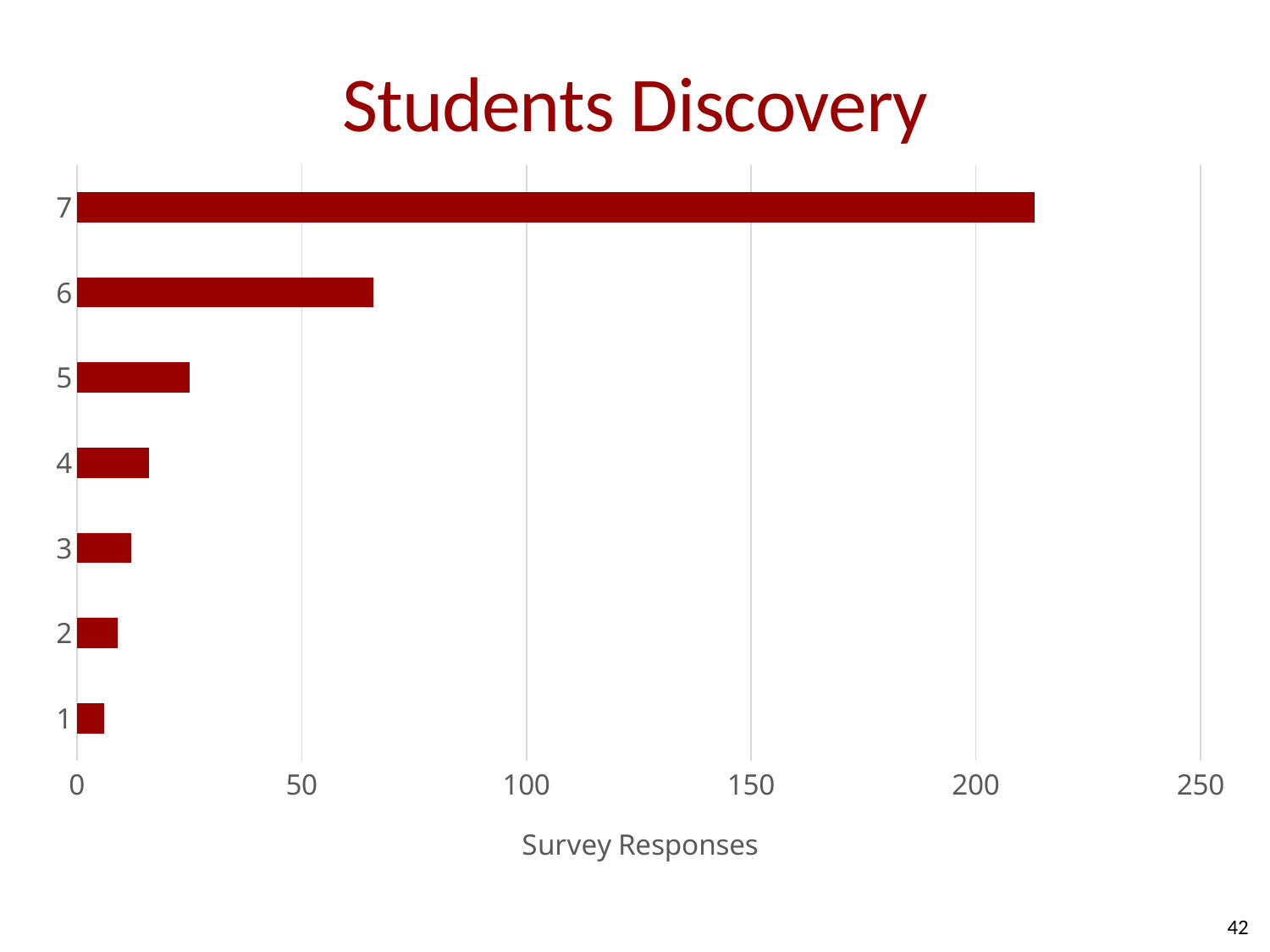
Is the value for category 6 greater or less than 50? greater What is the title of the chart? Students Discovery What is the label on the horizontal axis? Survey Responses Which category has the lowest number of survey responses? 1 Is the value for category 6 greater or less than 100? less Is the value for category 5 greater or less than 50? less What kind of chart is shown on the slide? bar chart Which has more survey responses, category 4 or category 7? 7 Which has more survey responses, category 6 or category 5? 6 Which category has the highest number of survey responses? 7 How many categories are plotted on the chart? 7